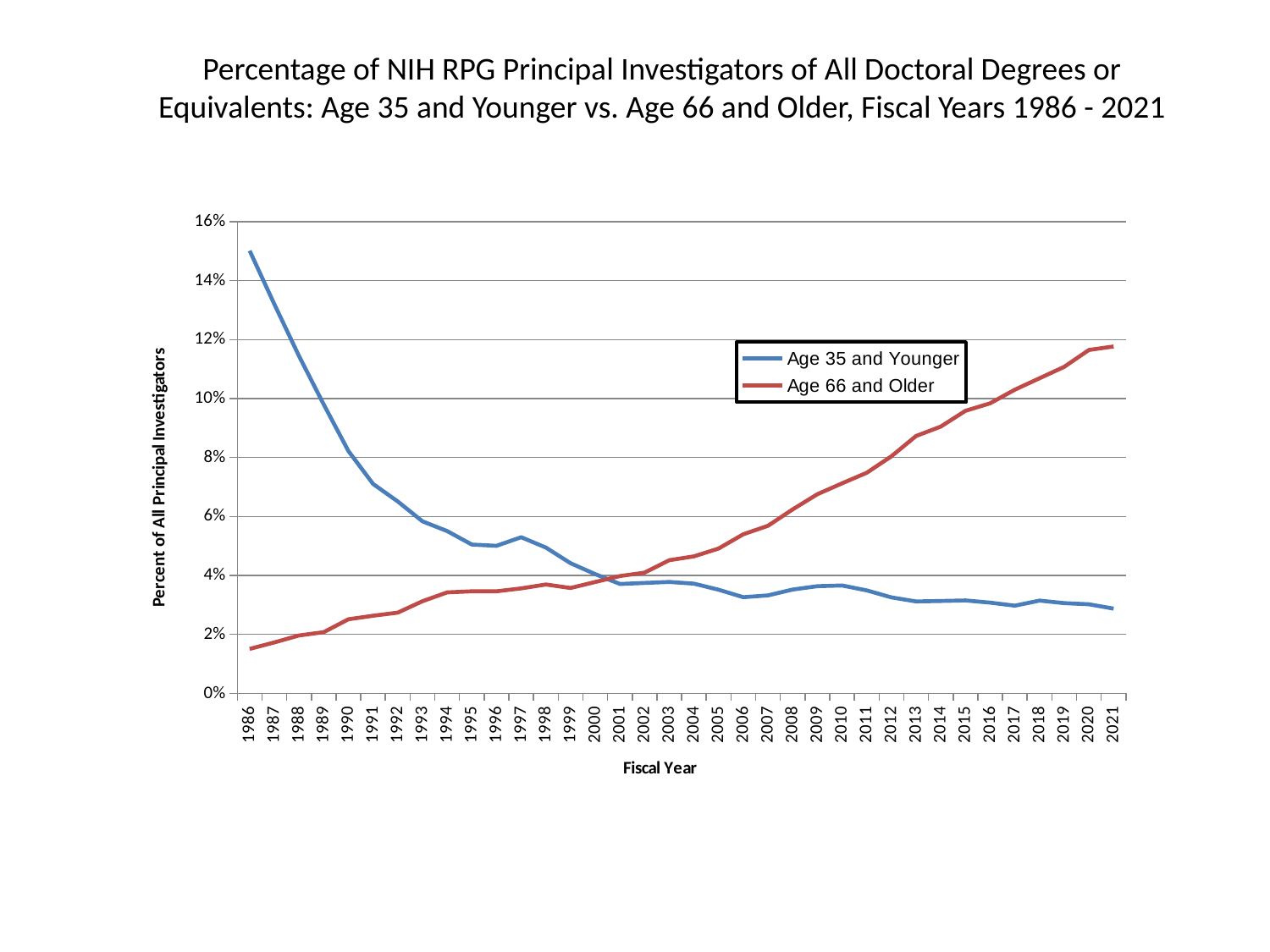
In which fiscal year is the Age 66 and Older series at its lowest? 1986 What kind of chart is shown on the slide? line chart In 1986, which series has the larger value, Age 35 and Younger or Age 66 and Older? Age 35 and Younger In which fiscal year is the Age 66 and Older series at its highest? 2021 Does the Age 66 and Older series rise or fall from 1986 to 2021? rise In 2021, which series has the larger value, Age 35 and Younger or Age 66 and Older? Age 66 and Older Is the value for Age 35 and Younger in 1986 greater or less than 14%? greater How many fiscal years are plotted along the x axis? 36 Does the Age 35 and Younger series rise or fall from 1986 to 2021? fall How many series does the legend list? 2 In which fiscal year is the Age 35 and Younger series at its highest? 1986 Is the value for Age 66 and Older in 2021 greater or less than 10%? greater